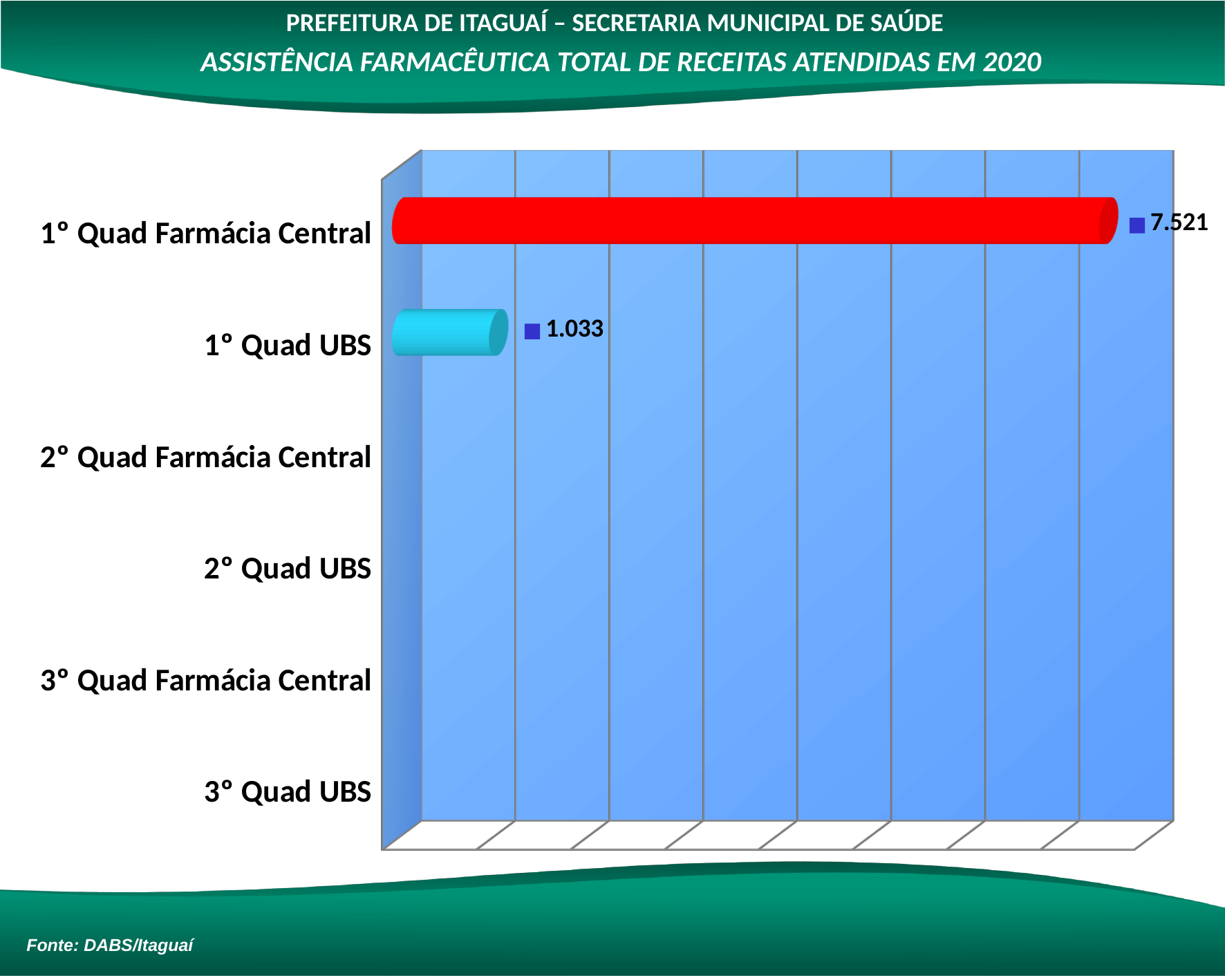
What kind of chart is shown on the slide? Bar chart What is the difference between the values for 1° Quad Farmácia Central and 1° Quad UBS? 6.488 What is the value for 1° Quad Farmácia Central? 7.521 What is the value for 1° Quad UBS? 1.033 How many categories on the chart have a bar with a data label? 2 What colour is the bar for 1° Quad Farmácia Central? Red What is the title of the chart on the slide? ASSISTÊNCIA FARMACÊUTICA TOTAL DE RECEITAS ATENDIDAS EM 2020 Which category has the highest value on the chart? 1° Quad Farmácia Central Which is larger, the value for 1° Quad Farmácia Central or the value for 1° Quad UBS? 1° Quad Farmácia Central How many categories are listed on the vertical axis of the chart? 6